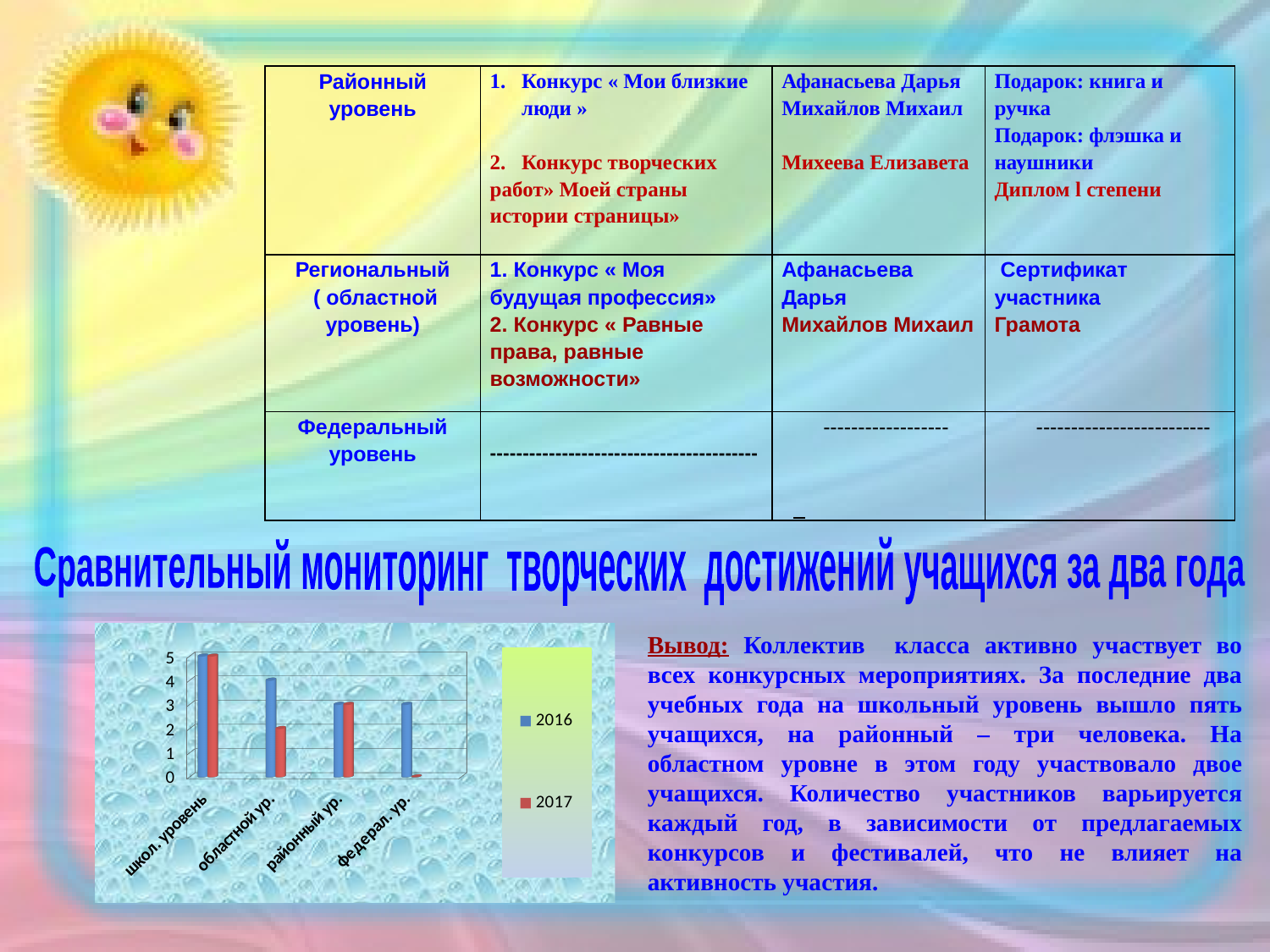
Which category has the lowest value for 2017? федерал. ур. Which category has the highest value for 2016? школ. уровень What kind of chart is shown on the slide? bar chart What is the value for школ. уровень in 2017? 5 What is the value for областной ур. in 2017? 2 For областной ур., which year has the larger value, 2016 or 2017? 2016 How many categories are shown on the x axis of the chart? 4 What is the value for районный ур. in 2017? 3 Is the value for областной ур. in 2016 greater or less than 3? greater How many series does the chart legend list? 2 Which years are listed in the chart legend? 2016 and 2017 Is the value for федерал. ур. in 2017 greater or less than 1? less